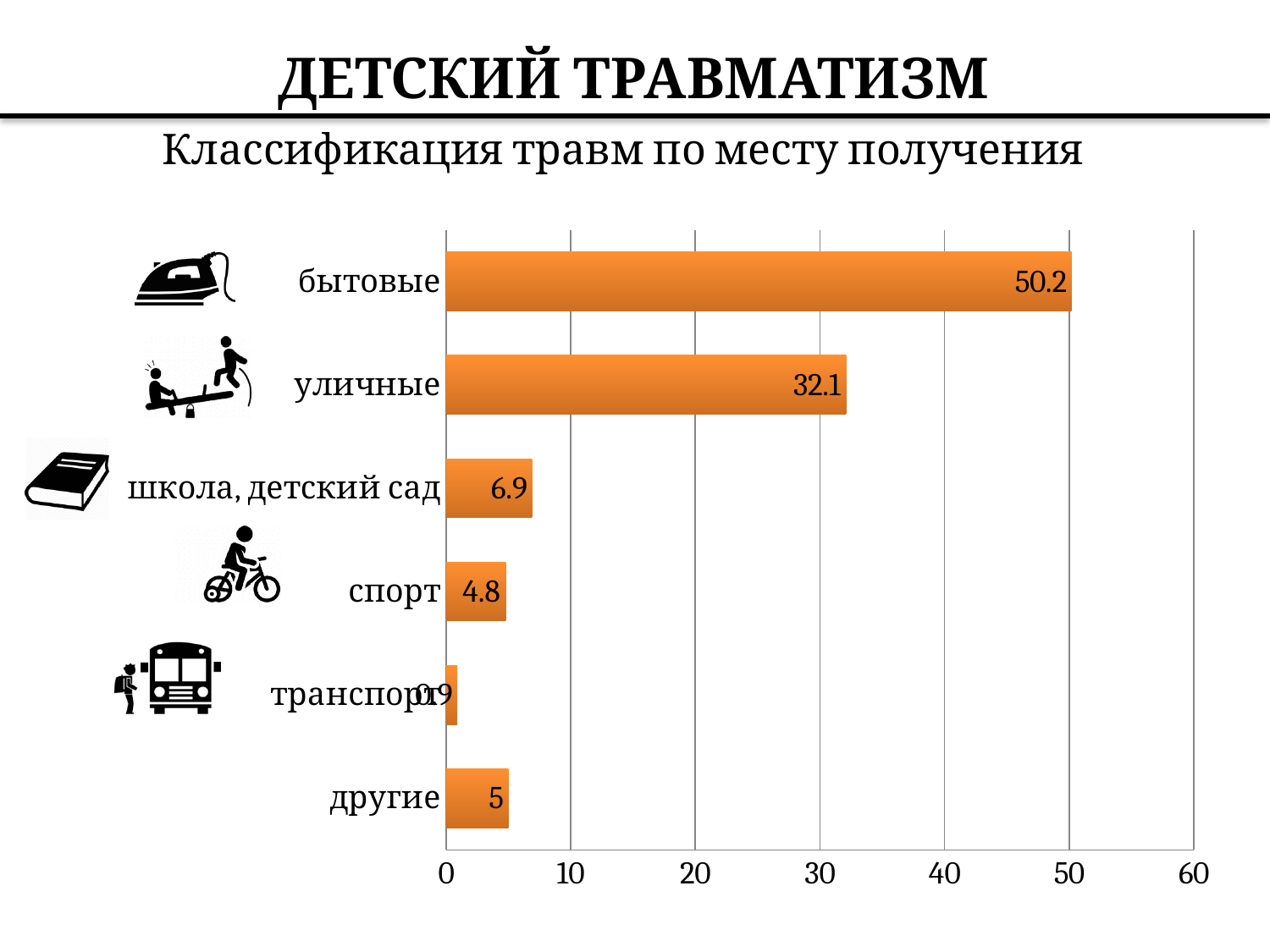
What type of chart is shown on the slide? bar chart Which category has the highest value? бытовые What is the difference between the values for бытовые and уличные? 18.1 What is the value for другие? 5 What is the value for уличные? 32.1 Which is larger, the value for школа, детский сад or the value for спорт? школа, детский сад How many categories are shown in the chart? 6 What is the value for школа, детский сад? 6.9 Is the value for транспорт greater or less than 10? less Which category has the lowest value? транспорт What is the value for бытовые? 50.2 What is the value for спорт? 4.8